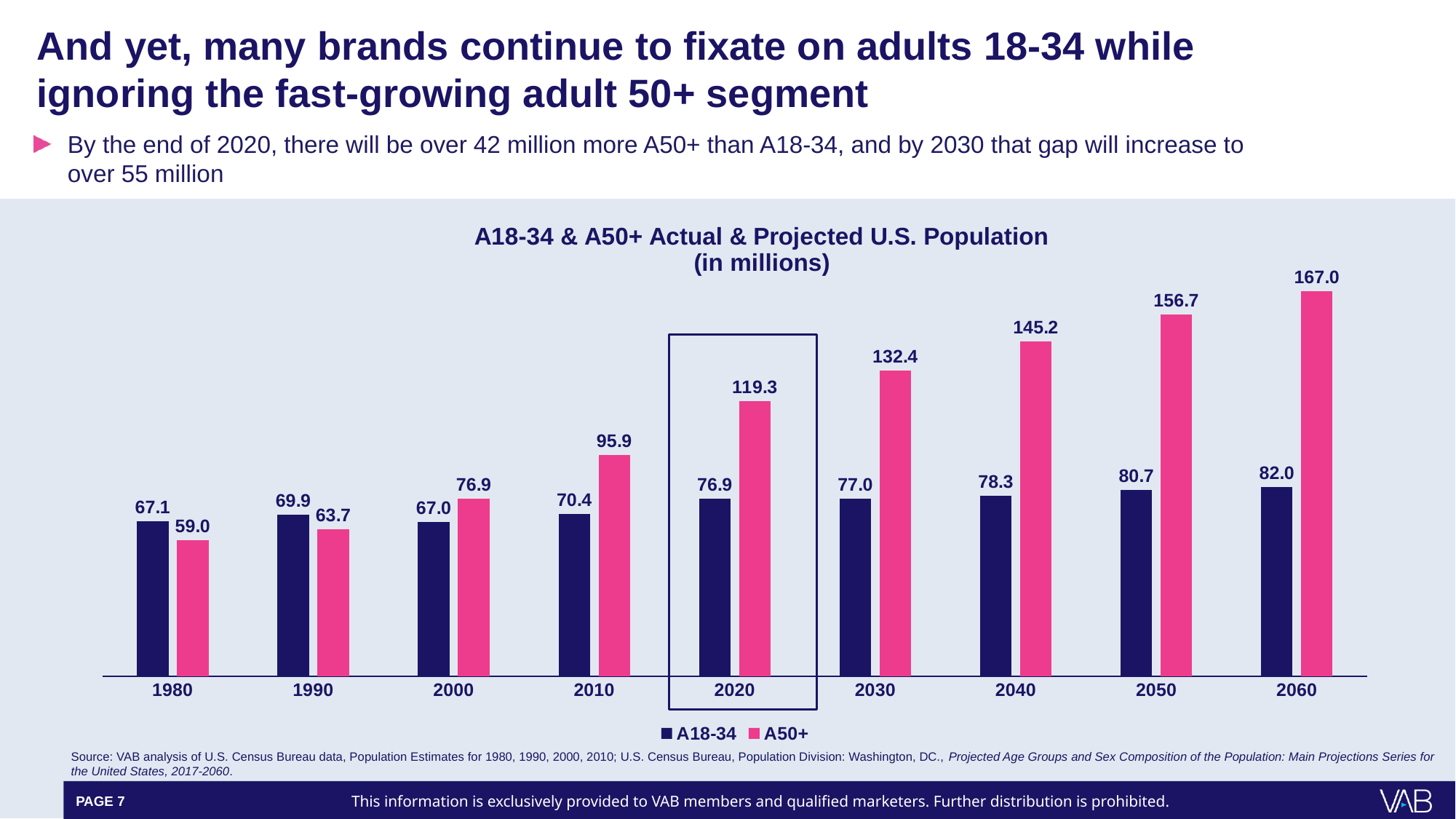
What is the A50+ value for 2060? 167.0 In which year is the A50+ value lowest? 1980 How many series does the legend list? 2 In which year is the A18-34 value highest? 2060 What kind of chart is this? bar chart What is the difference between the A50+ and A18-34 values in 2030? 55.4 Which is larger in 1990, A18-34 or A50+? A18-34 How many years are shown on the x axis? 9 Do the A50+ values rise or fall from 1980 to 2060? rise What is the title of the chart? A18-34 & A50+ Actual & Projected U.S. Population (in millions) What is the A18-34 value for 1980? 67.1 What is the A50+ value for 2020? 119.3